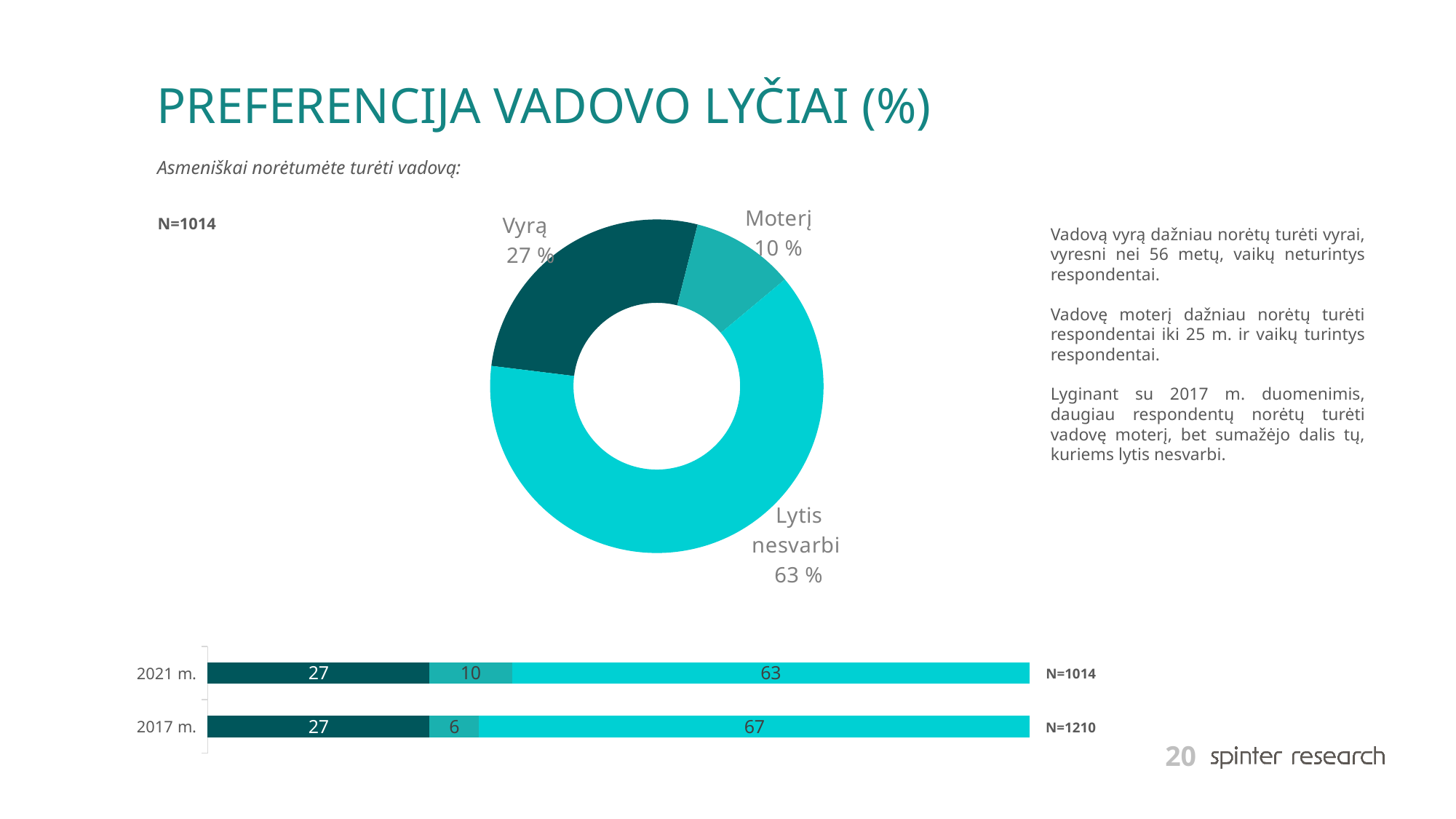
In the bottom stacked bar chart, what is the value of the middle segment for 2017 m.? 6 In the donut chart, which category has the largest share? Lytis nesvarbi In the donut chart, what is the difference in percentage points between Lytis nesvarbi and Vyrą? 36 In the donut chart, how many categories are shown? 3 In the donut chart, which category has the smallest share? Moterį In the bottom stacked bar chart, what is the value of the last (light cyan) segment for 2017 m.? 67 In the donut chart, what percentage of respondents would prefer a female manager (Moterį)? 10 % In the bottom stacked bar chart, what is the total of the 2021 m. bar? 100 In the bottom stacked bar chart, which year has the larger middle segment, 2021 m. or 2017 m.? 2021 m. What sample size (N) is shown for the 2017 m. bar in the bottom chart? N=1210 What type of chart is the upper chart on the slide? Donut chart In the donut chart, what percentage of respondents would prefer a male manager (Vyrą)? 27 %